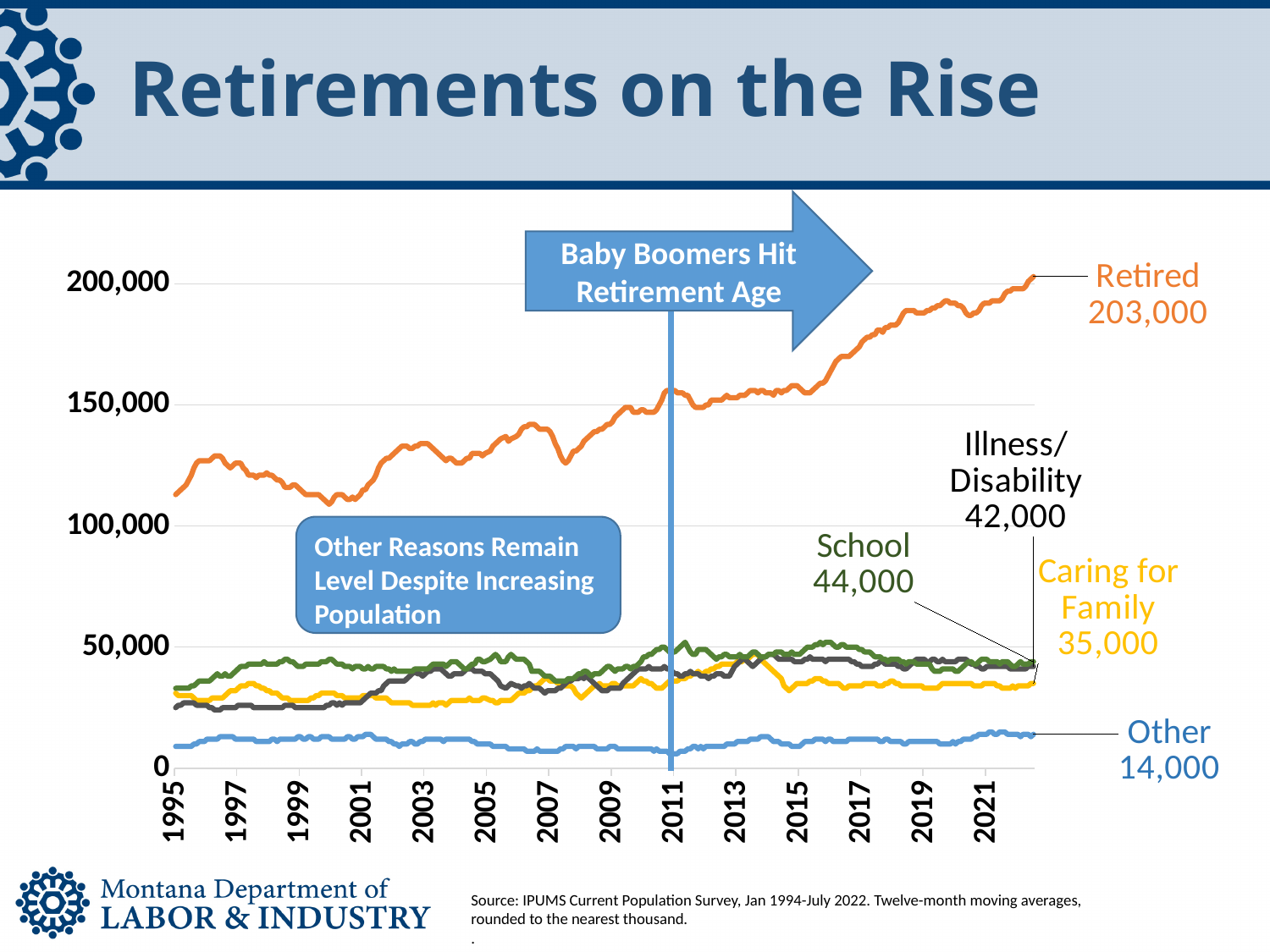
Does the Retired series generally rise or fall from 2011 to 2021? Rise What is the final value shown for the Retired series? 203,000 Which series has the lowest final value? Other What kind of chart is shown on the slide? Line chart Which series has the highest final value? Retired What is the difference between the final values of Retired and Other? 189,000 What is the final value shown for the Illness/Disability series? 42,000 What is the final value shown for the Other series? 14,000 Is the value for Retired in 1995 greater or less than 100,000? greater What is the final value shown for the School series? 44,000 What is the final value shown for the Caring for Family series? 35,000 Which has a larger final value, School or Caring for Family? School